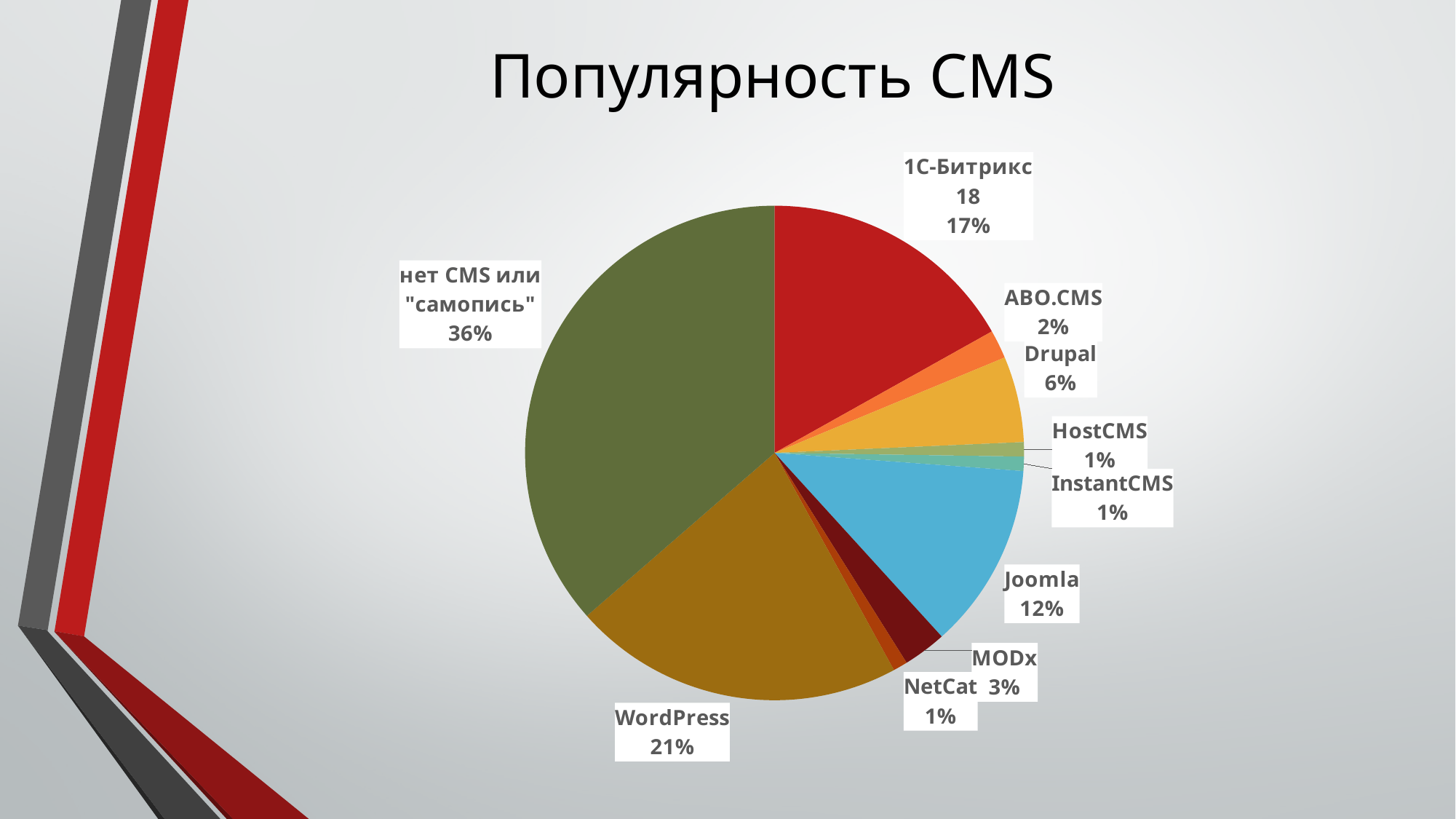
What is the percentage shown for Drupal? 6% What is the difference in percentage points between нет CMS или "самопись" and 1С-Битрикс? 19% What percentage is shown for MODx? 3% How many categories are shown in the pie chart? 10 What value is printed for 1С-Битрикс besides its percentage? 18 Which category has the largest slice of the pie? нет CMS или "самопись" What type of chart is shown on the slide? pie chart What is the title of the chart? Популярность CMS What is the difference in percentage points between WordPress and Joomla? 9% What percentage is shown for Joomla? 12% Which is larger, the share for 1С-Битрикс or the share for Joomla? 1С-Битрикс What share of the pie does WordPress have? 21%